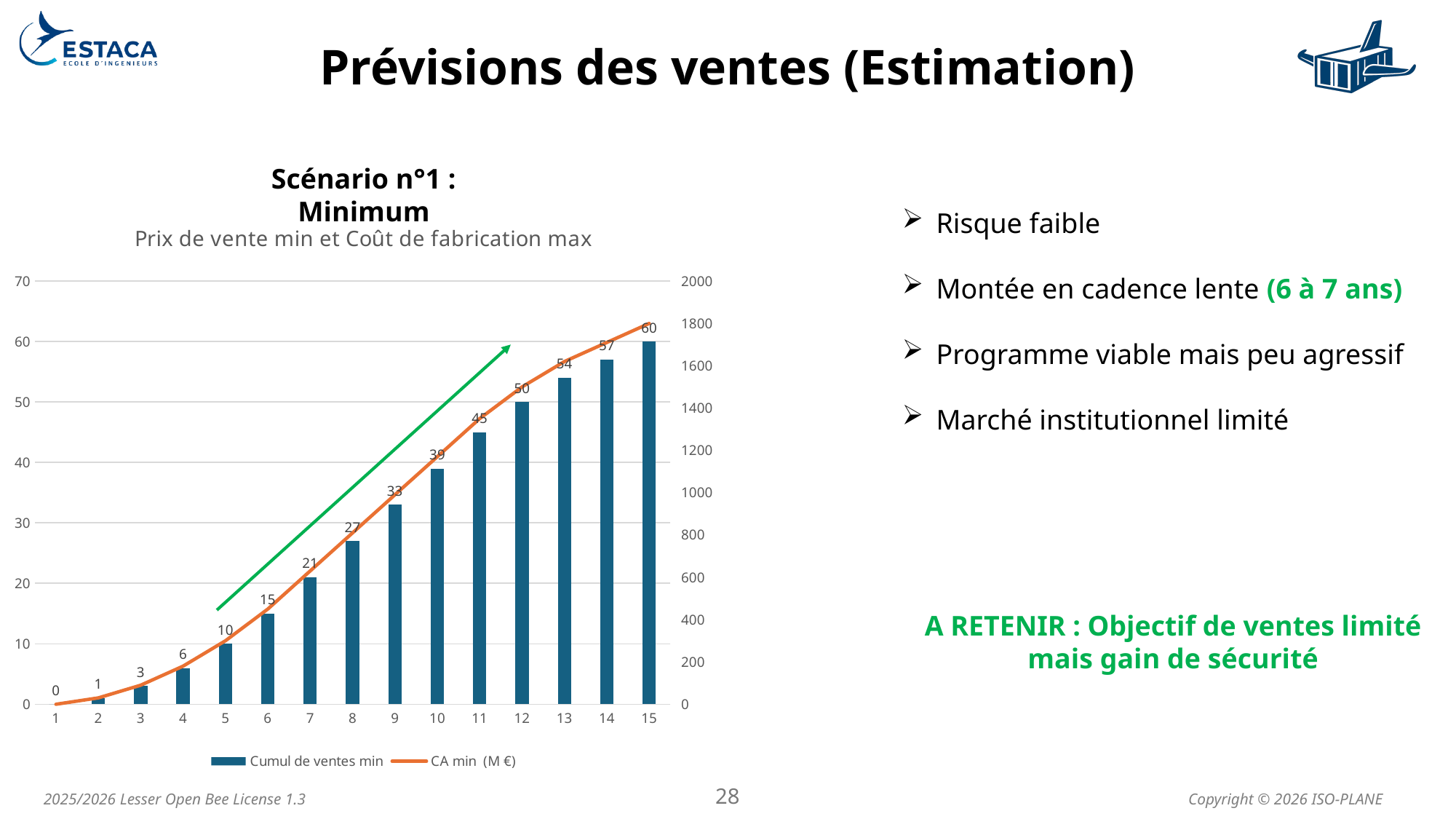
What is the value of the 'Cumul de ventes min' bar at x = 7? 21 Is the value of the 'CA min (M €)' line at x = 15 greater or less than 1600 on the right-hand axis? greater What is the subtitle shown under 'Scénario n°1 : Minimum' above the chart? Prix de vente min et Coût de fabrication max How many categories are shown on the x axis of the chart? 15 At which x-axis category is the 'Cumul de ventes min' bar highest? 15 What is the difference between the 'Cumul de ventes min' values at x = 15 and x = 12? 10 At which x-axis category is the 'Cumul de ventes min' bar lowest? 1 How many series does the chart legend list? 2 What is the value of the 'Cumul de ventes min' bar at x = 13? 54 What is the value of the 'Cumul de ventes min' bar at x = 10? 39 Which is larger, the 'Cumul de ventes min' value at x = 6 or at x = 9? 9 Is the value of the 'CA min (M €)' line at x = 5 greater or less than 400 on the right-hand axis? less